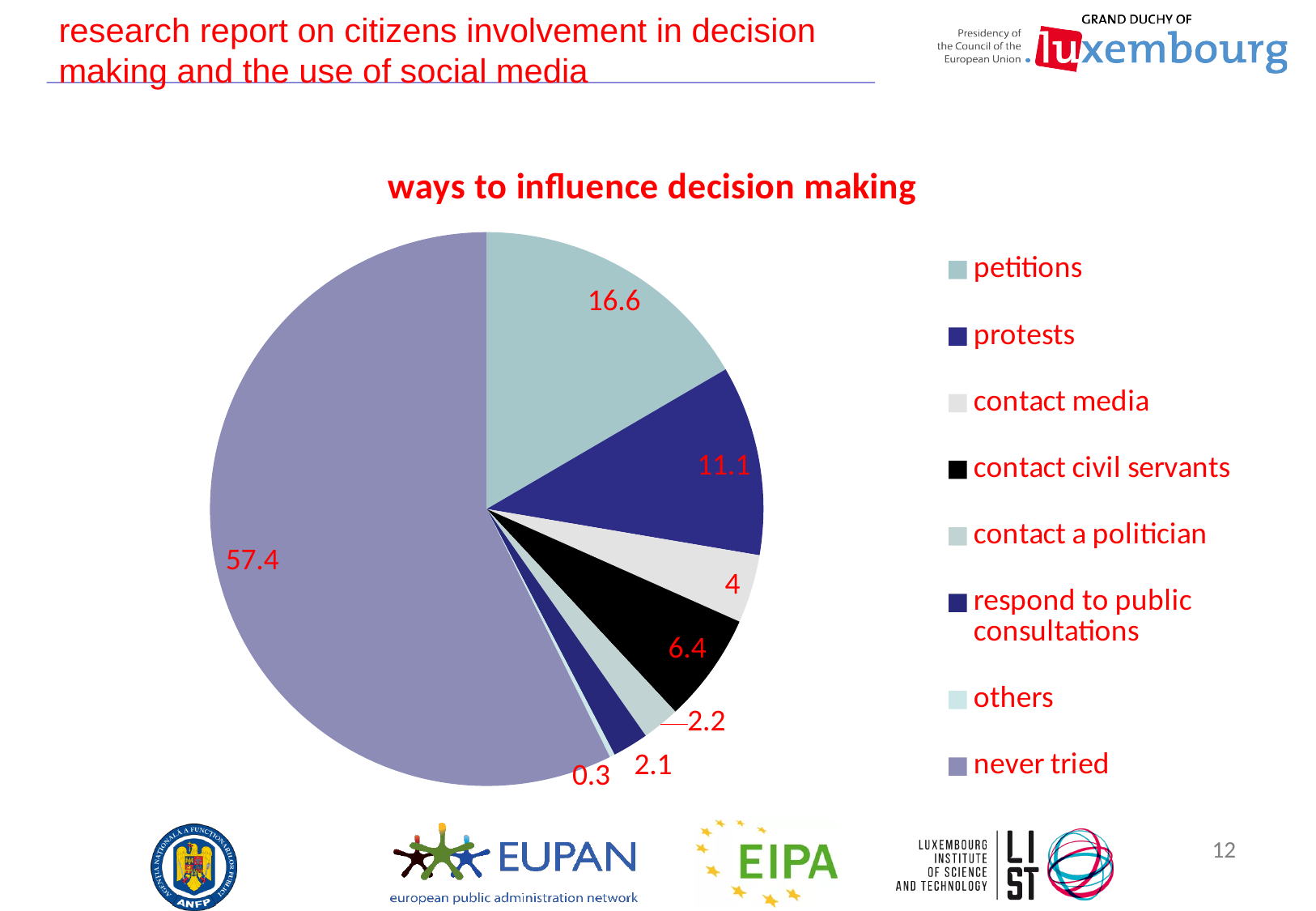
What type of chart is shown on the slide? pie chart What is the value for petitions? 16.6 Which is larger, the value for contact media or the value for contact civil servants? contact civil servants What is the title of the chart? ways to influence decision making How many categories does the legend list? 8 What is the value for never tried? 57.4 Which category has the smallest slice of the pie? others Which category has the largest slice of the pie? never tried What is the value for contact media? 4 What is the value for protests? 11.1 What is the value for contact civil servants? 6.4 What is the difference between the values for petitions and protests? 5.5